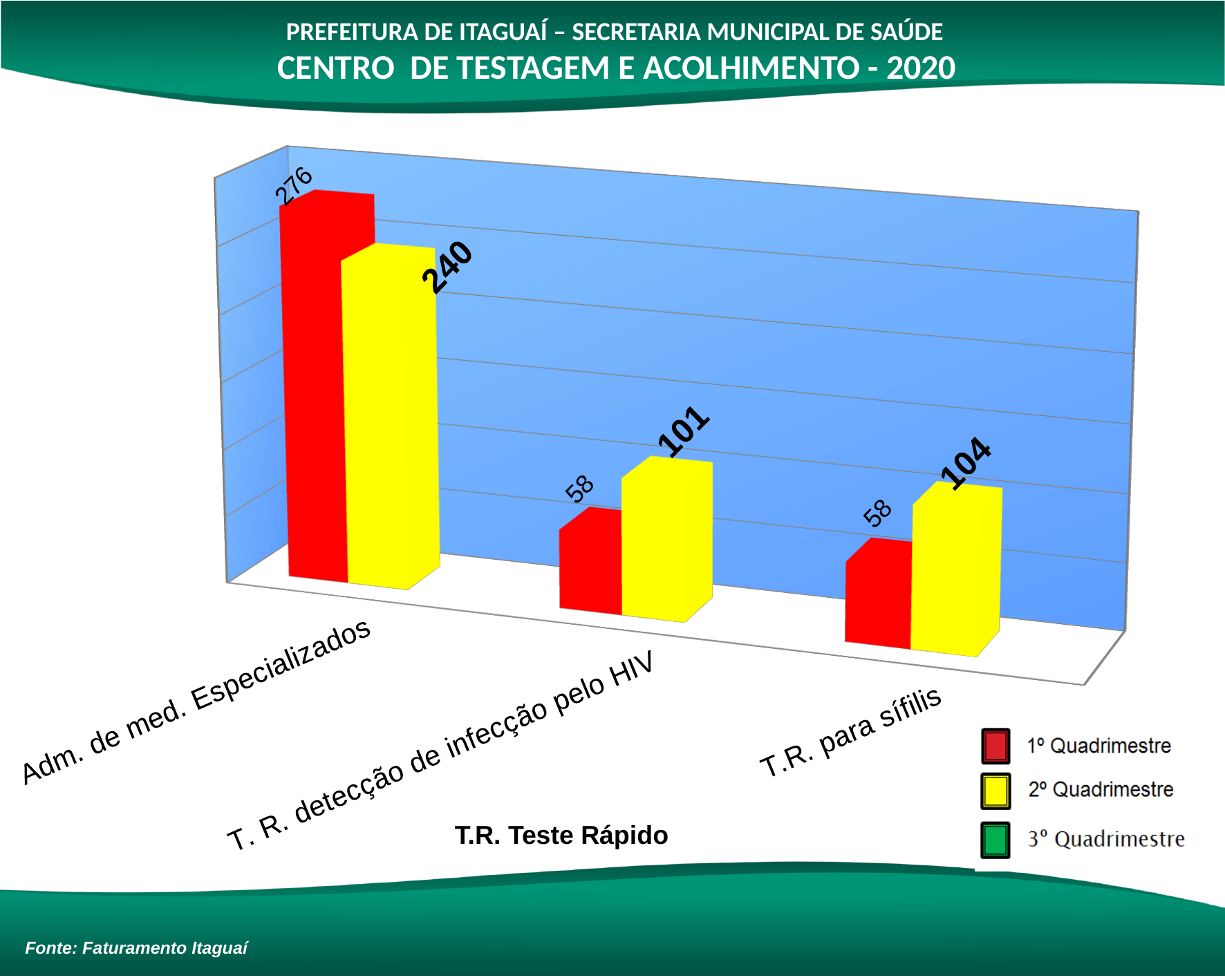
What is the value for Adm. de med. Especializados in the 1º Quadrimestre? 276 What is the difference between the 1º Quadrimestre and 2º Quadrimestre values for Adm. de med. Especializados? 36 What is the value for Adm. de med. Especializados in the 2º Quadrimestre? 240 What is the value for T. R. detecção de infecção pelo HIV in the 2º Quadrimestre? 101 How many series does the legend list? 3 What kind of chart is shown on the slide? Bar chart For T. R. detecção de infecção pelo HIV, which is larger: the 1º Quadrimestre or the 2º Quadrimestre value? 2º Quadrimestre Which category has the lowest value in the 2º Quadrimestre? T. R. detecção de infecção pelo HIV What is the value for T.R. para sífilis in the 1º Quadrimestre? 58 How many categories are shown on the x axis of the chart? 3 What is the difference between the 2º Quadrimestre and 1º Quadrimestre values for T.R. para sífilis? 46 Which category has the highest value in the 1º Quadrimestre? Adm. de med. Especializados